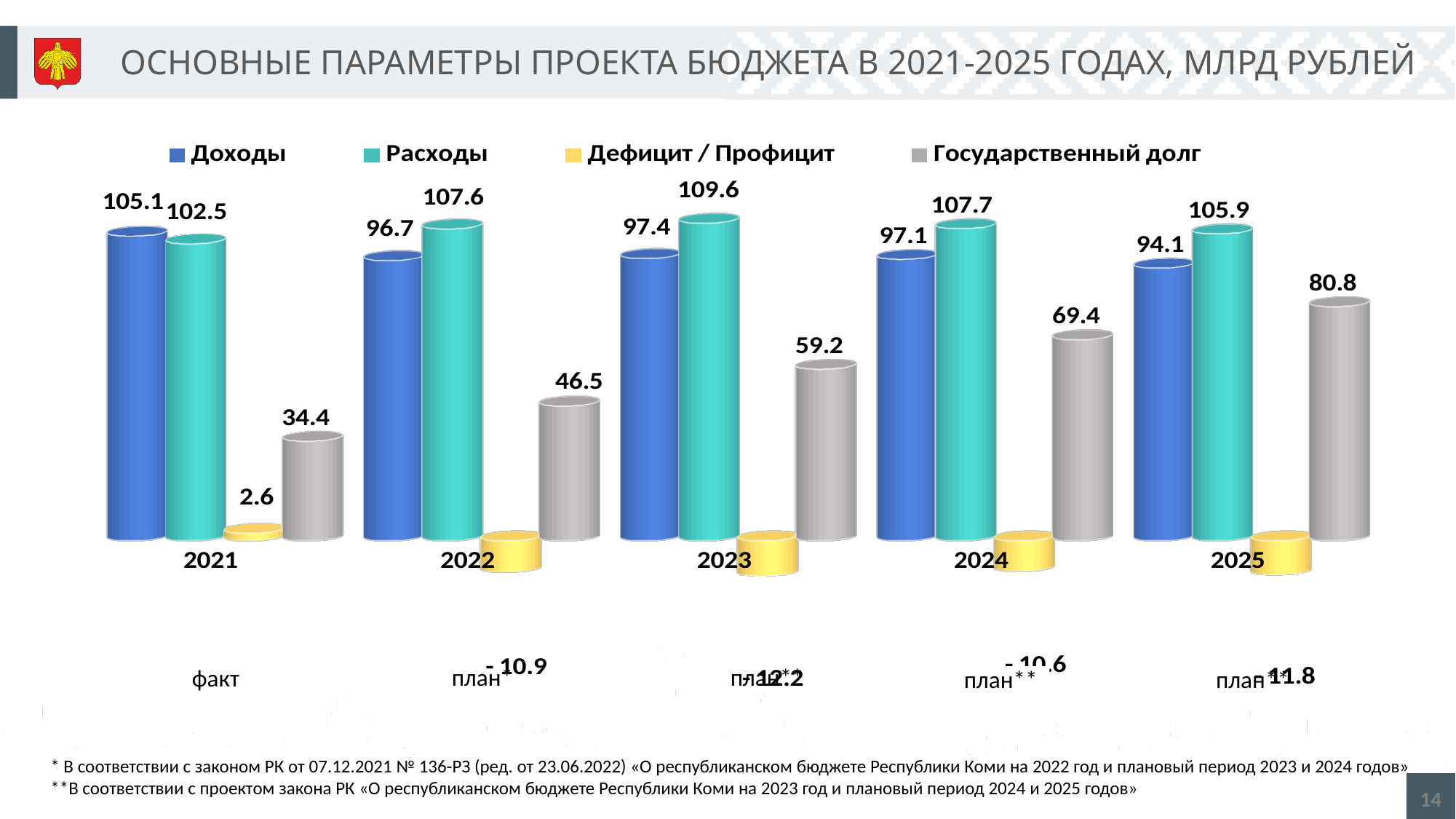
What kind of chart is shown on the slide? Bar chart Which is larger in 2021, Доходы or Расходы? Доходы What is the value of Расходы for 2023? 109.6 What is the value of Доходы for 2021? 105.1 In which year is Доходы the lowest? 2025 In which year is Государственный долг the highest? 2025 How many series does the legend list? 4 Does Государственный долг rise or fall from 2021 to 2025? Rises What is the value of Государственный долг for 2025? 80.8 What is the value of Дефицит / Профицит for 2022? - 10.9 How many years are shown on the x axis? 5 What is the difference between Расходы and Доходы in 2022? 10.9